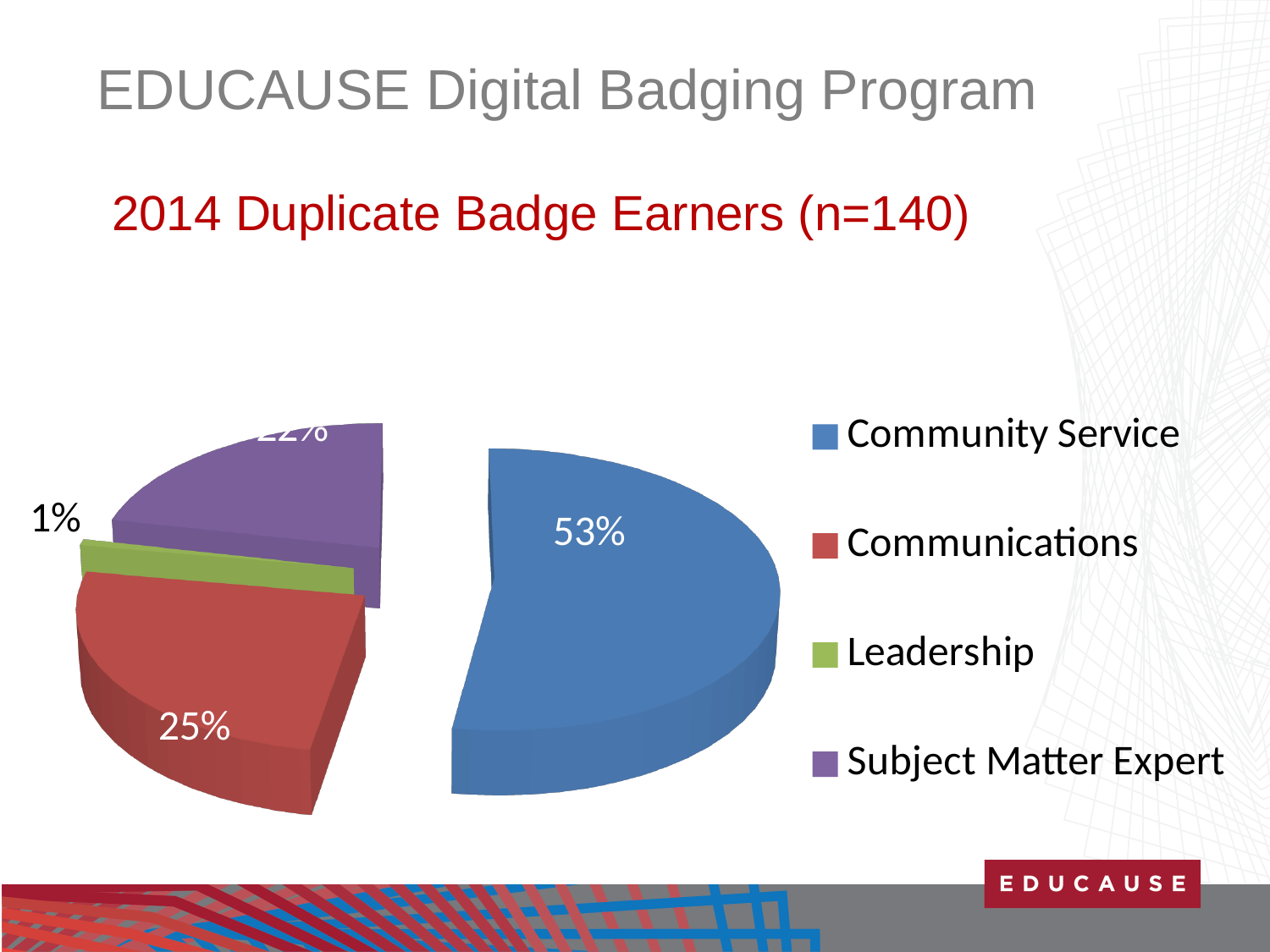
Which slice is larger, Communications or Leadership? Communications What is the title of the chart? 2014 Duplicate Badge Earners (n=140) What is the difference in percentage points between Communications and Leadership? 24% What kind of chart is shown on the slide? pie chart What colour is the Community Service slice? blue What percentage of the pie is Leadership? 1% Which category has the smallest slice of the pie? Leadership What percentage of the pie is Communications? 25% Which category has the largest slice of the pie? Community Service What percentage of the pie is Community Service? 53% How many categories does the pie chart have? 4 What is the difference in percentage points between Community Service and Communications? 28%